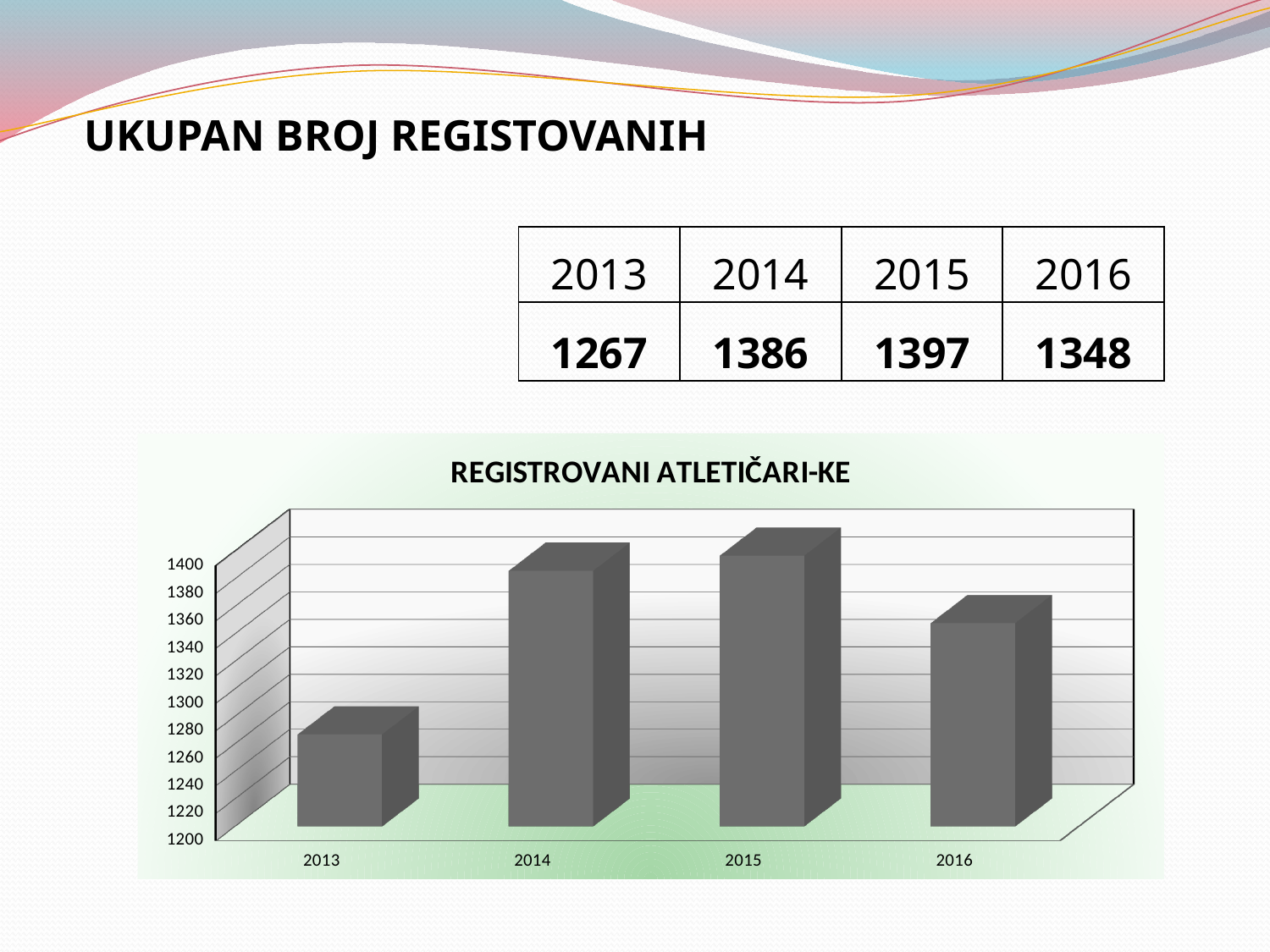
Which year has the highest value in the REGISTROVANI ATLETIČARI-KE chart? 2015 What is the title of the chart on the slide? REGISTROVANI ATLETIČARI-KE Which year has the lowest value in the REGISTROVANI ATLETIČARI-KE chart? 2013 Which is larger in the REGISTROVANI ATLETIČARI-KE chart, the value for 2014 or the value for 2016? 2014 What is the difference between the values for 2015 and 2016 in the REGISTROVANI ATLETIČARI-KE chart? 49 What is the value for 2013 in the REGISTROVANI ATLETIČARI-KE chart? 1267 Is the value for 2013 in the REGISTROVANI ATLETIČARI-KE chart greater or less than 1300? less What kind of chart is the REGISTROVANI ATLETIČARI-KE chart? bar chart How many years are shown on the x axis of the REGISTROVANI ATLETIČARI-KE chart? 4 What is the difference between the values for 2014 and 2013 in the REGISTROVANI ATLETIČARI-KE chart? 119 What is the value for 2015 in the REGISTROVANI ATLETIČARI-KE chart? 1397 What is the value for 2016 in the REGISTROVANI ATLETIČARI-KE chart? 1348